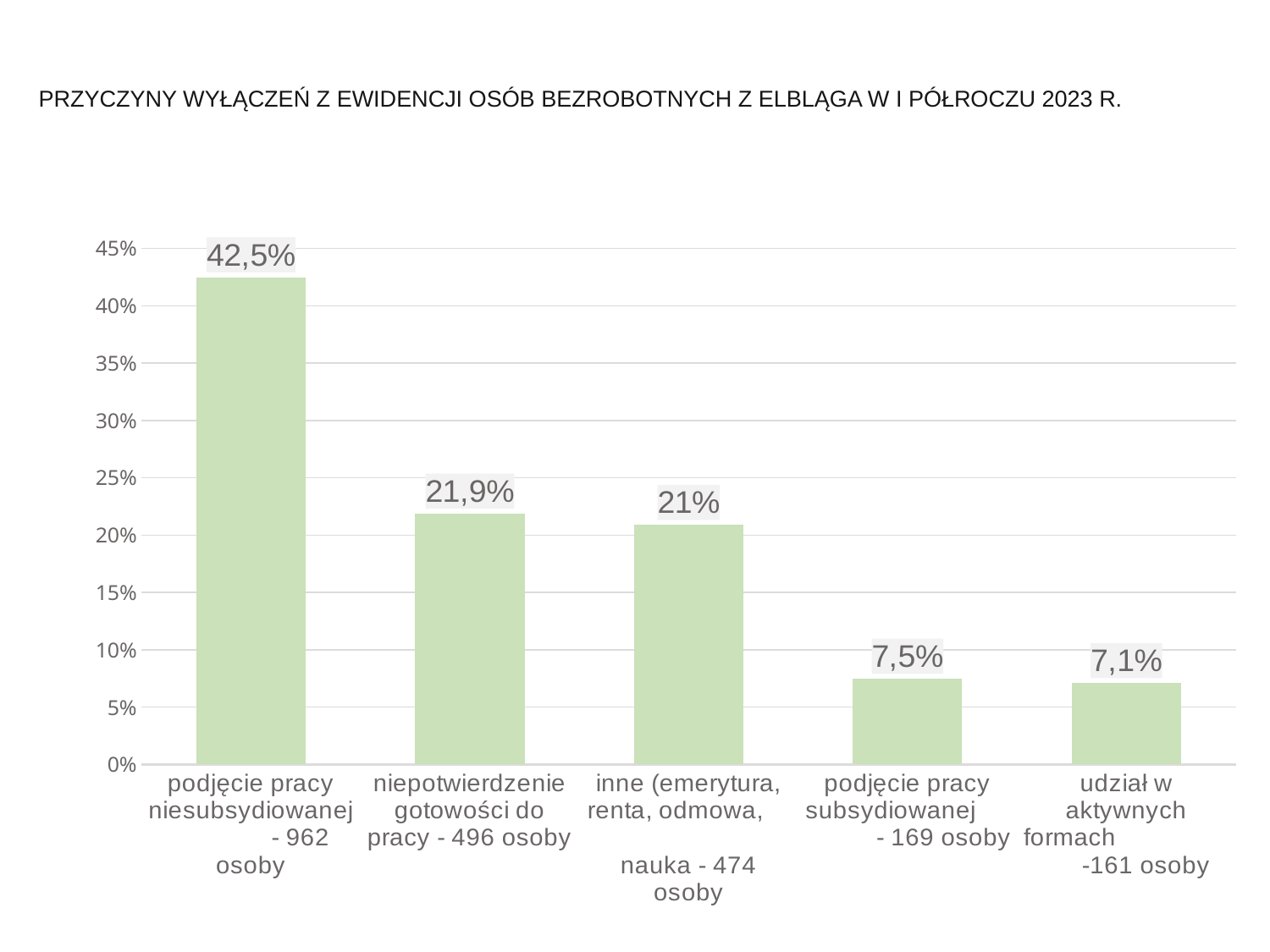
What kind of chart is shown on the slide? bar chart What is the difference between the values for 'podjęcie pracy niesubsydiowanej' and 'niepotwierdzenie gotowości do pracy'? 20,6% What is the value for 'podjęcie pracy subsydiowanej - 169 osoby'? 7,5% Is the value for 'inne (emerytura, renta, odmowa, nauka)' greater or less than 25%? less What is the value for 'inne (emerytura, renta, odmowa, nauka - 474 osoby)'? 21% Which category has the lowest value? udział w aktywnych formach - 161 osoby What is the value for 'udział w aktywnych formach - 161 osoby'? 7,1% How many categories are shown on the chart? 5 Which category has the highest value? podjęcie pracy niesubsydiowanej - 962 osoby What is the value for 'podjęcie pracy niesubsydiowanej - 962 osoby'? 42,5% Which is larger: the value for 'podjęcie pracy subsydiowanej' or 'udział w aktywnych formach'? podjęcie pracy subsydiowanej What is the value for 'niepotwierdzenie gotowości do pracy - 496 osoby'? 21,9%